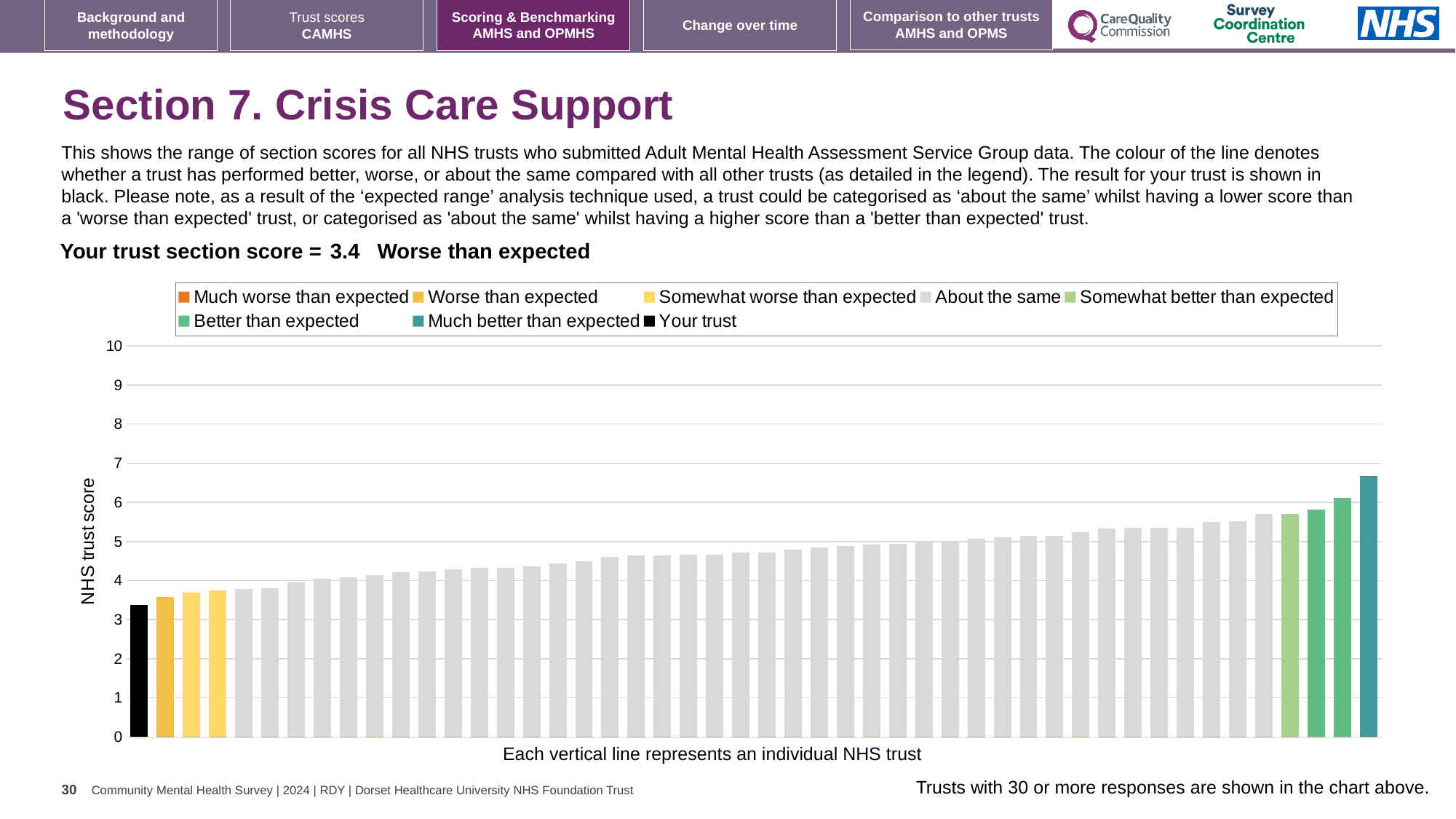
What kind of chart is shown on the slide? bar chart Do the bar values rise or fall from left to right along the x axis? rise Which bar is the lowest in the chart? Your trust What colour is used for the 'Your trust' bar? black Is the value of the black 'Your trust' bar greater or less than 4? less Which performance category is your trust placed in for this section? Worse than expected Is the 'Your trust' bar higher or lower than the 'Much better than expected' bar? lower How many entries does the chart legend list? 8 How many bars are coloured as 'Better than expected'? 2 What is the section score for your trust? 3.4 What is the label on the y axis of the chart? NHS trust score Is the value of the tallest bar (the 'Much better than expected' trust) greater or less than 6? greater